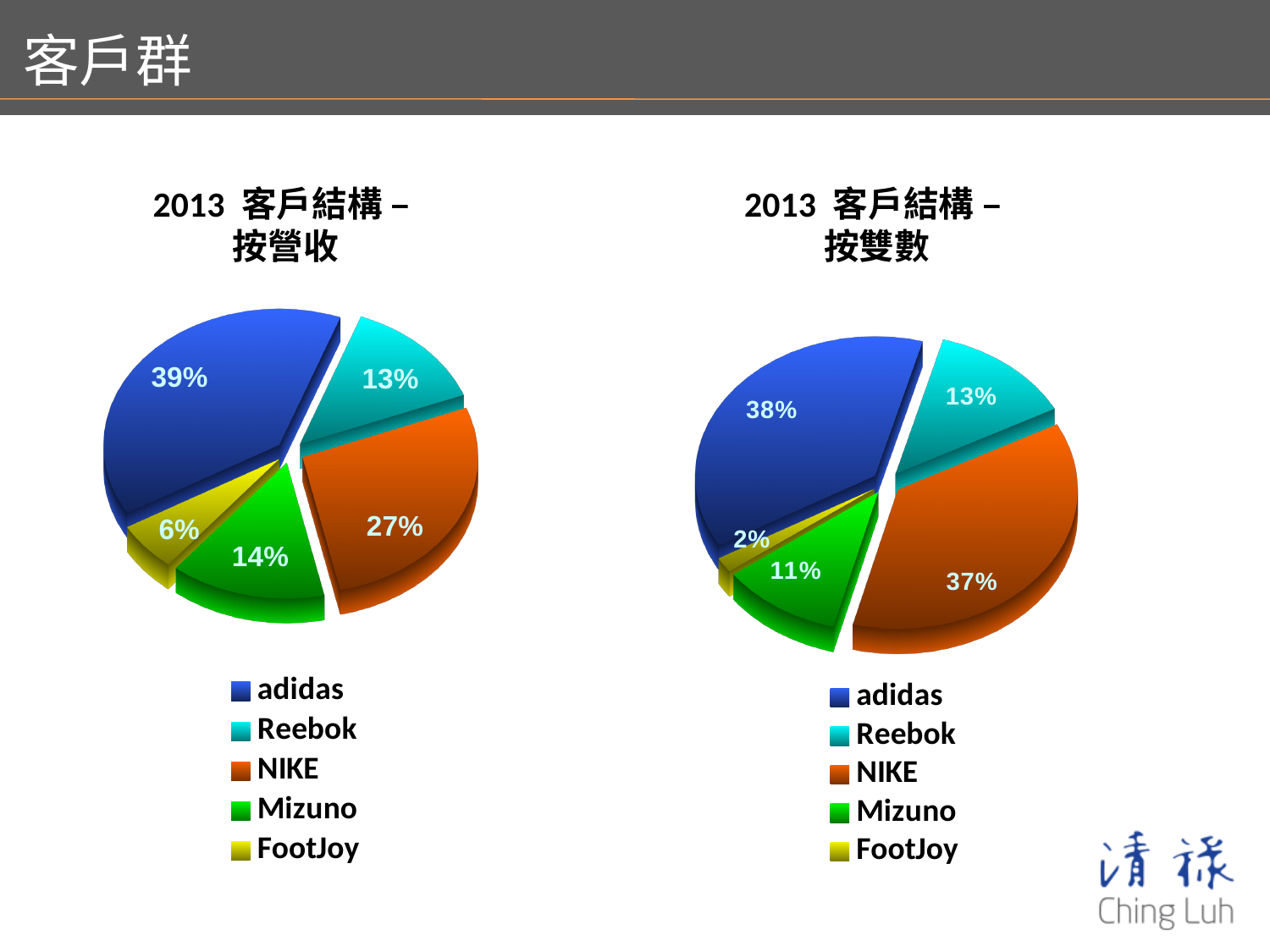
In the left chart (2013 客戶結構 – 按營收), what share does adidas have? 39% In the right chart (2013 客戶結構 – 按雙數), what share does Mizuno have? 11% In the right chart (2013 客戶結構 – 按雙數), which is larger, the Reebok share or the Mizuno share? Reebok How many customers are shown in the legend of the left chart (2013 客戶結構 – 按營收)? 5 In the left chart (2013 客戶結構 – 按營收), what share does FootJoy have? 6% In the right chart (2013 客戶結構 – 按雙數), what share does NIKE have? 37% In the left chart (2013 客戶結構 – 按營收), what is the difference between the adidas share and the NIKE share? 12% In the right chart (2013 客戶結構 – 按雙數), which colour represents NIKE? Orange In the right chart (2013 客戶結構 – 按雙數), which customer has the smallest share? FootJoy What type of chart is used for 2013 客戶結構 – 按雙數? Pie chart In the left chart (2013 客戶結構 – 按營收), what share does NIKE have? 27% In the left chart (2013 客戶結構 – 按營收), which customer has the largest share? adidas